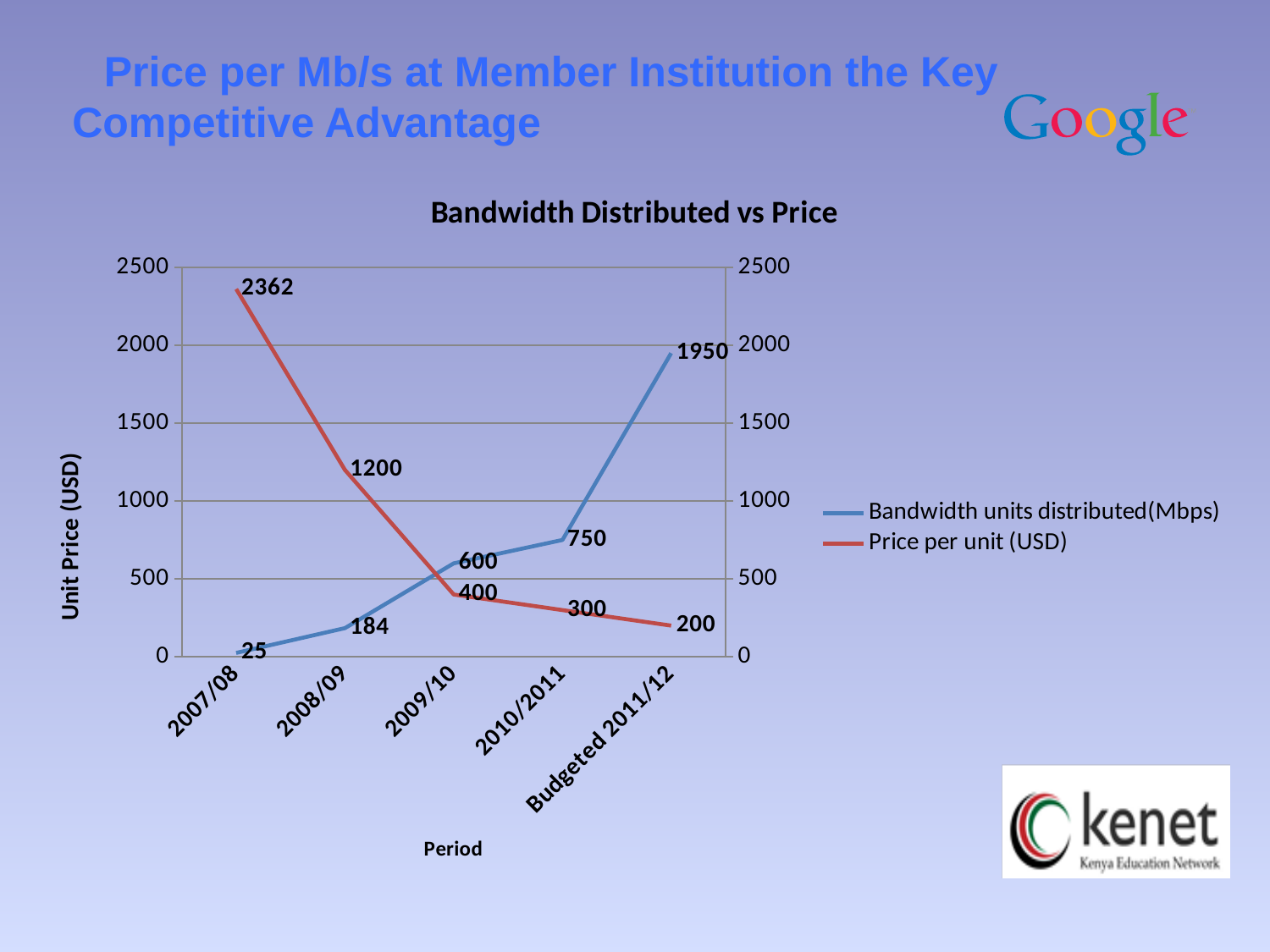
Does the Price per unit (USD) rise or fall across the periods? Fall What is the Price per unit (USD) for 2007/08? 2362 Which is larger in 2010/2011: Bandwidth units distributed (Mbps) or Price per unit (USD)? Bandwidth units distributed (Mbps) What is the Bandwidth units distributed (Mbps) for Budgeted 2011/12? 1950 What is the Bandwidth units distributed (Mbps) for 2009/10? 600 What kind of chart is this? Line chart How many periods are shown on the x axis? 5 What is the difference between the Price per unit (USD) in 2007/08 and in 2008/09? 1162 In which period is the Price per unit (USD) highest? 2007/08 What is the Price per unit (USD) for 2010/2011? 300 In which period is the Bandwidth units distributed (Mbps) lowest? 2007/08 How many series does the legend list? 2